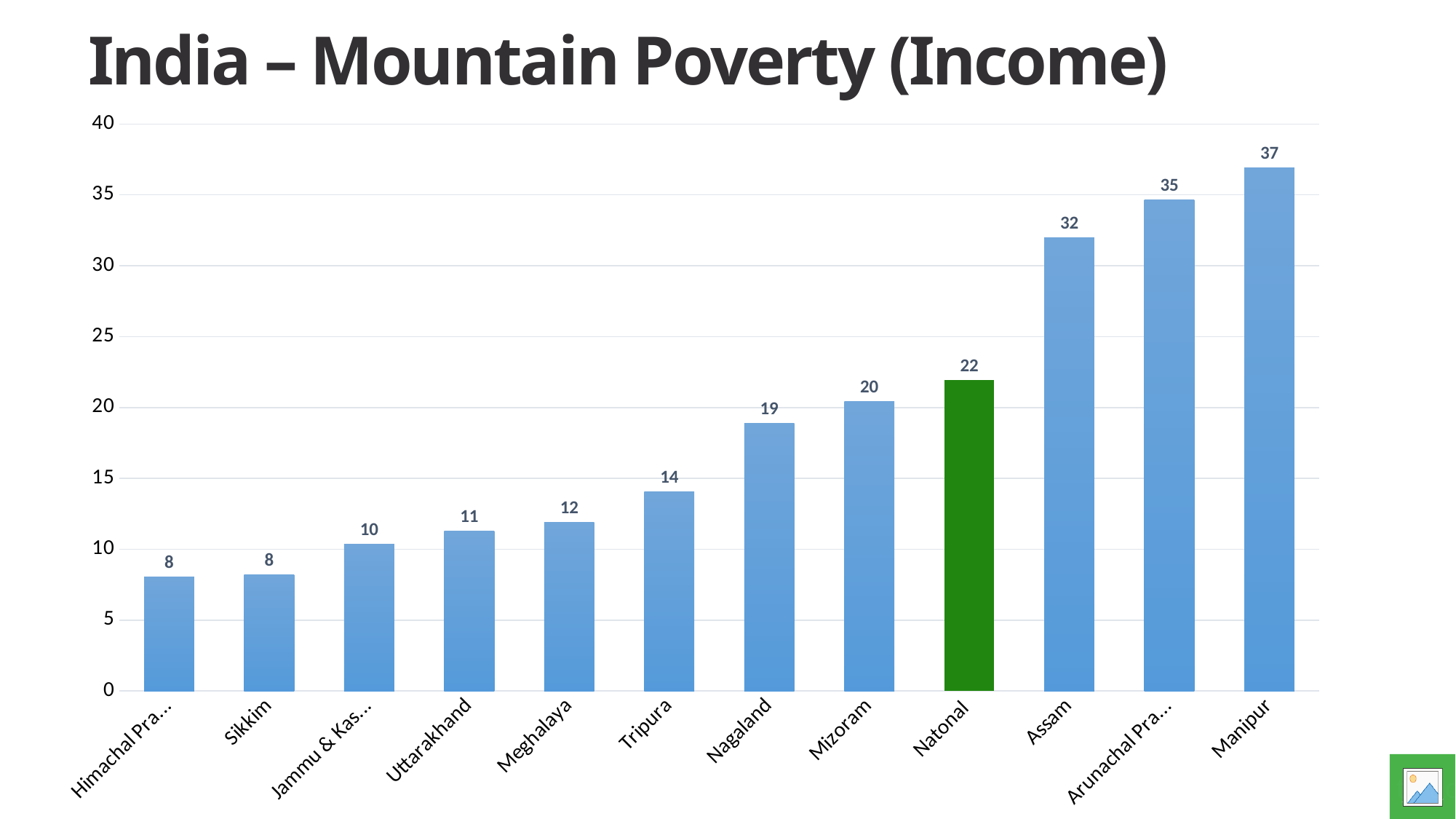
How many bars are shown in the chart? 12 What is the value for Manipur? 37 Is the value for Arunachal Pradesh greater or less than 30? greater Do the values generally rise or fall from left to right along the x axis? Rise What is the title of the chart? India – Mountain Poverty (Income) Which category has the highest value? Manipur Which is larger, the value for Nagaland or the value for Meghalaya? Nagaland What is the difference between the values for Assam and Tripura? 18 What is the value for the National bar? 22 Which bar is coloured green rather than blue? Natonal What is the value for Mizoram? 20 What kind of chart is shown on the slide? Bar chart